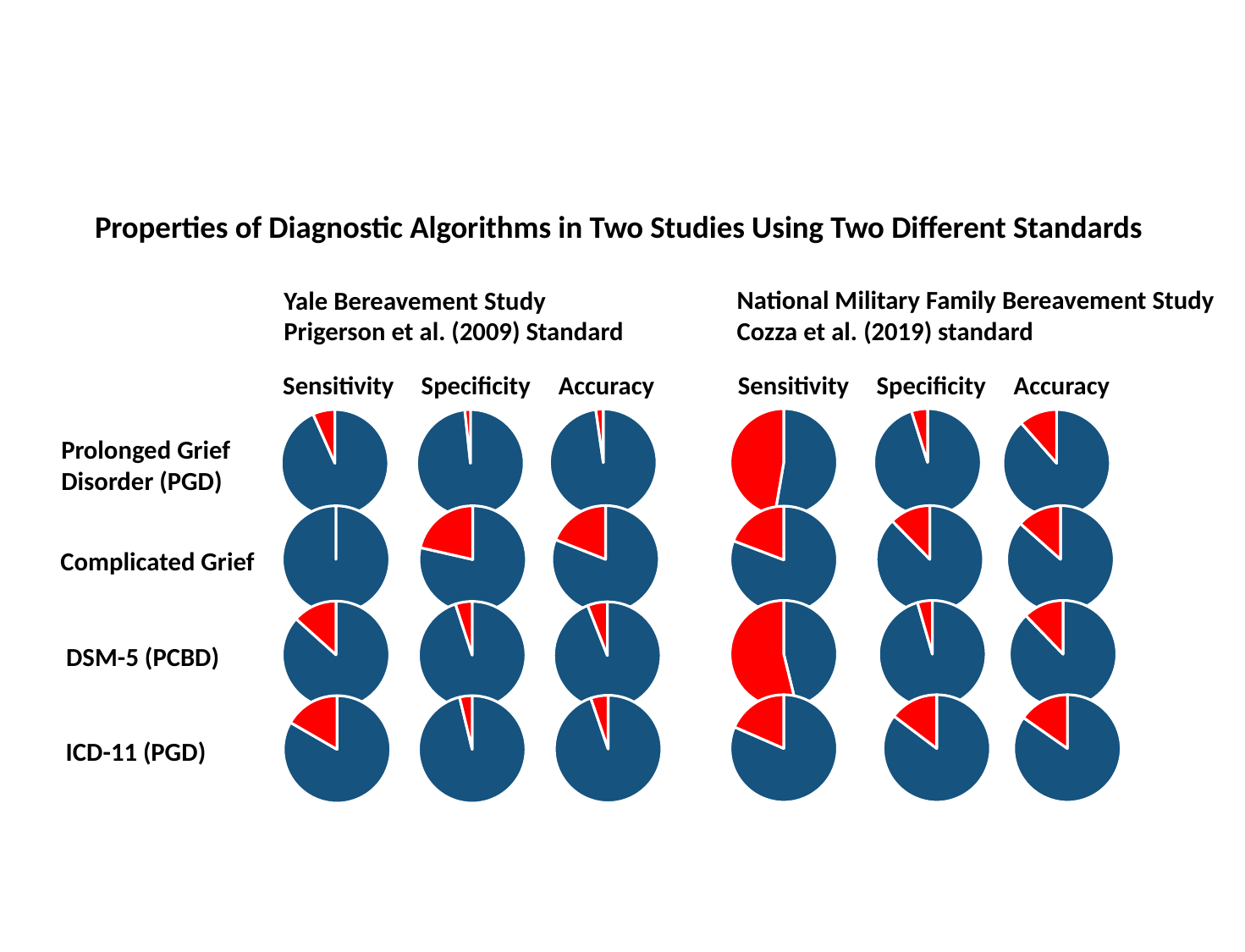
How many pie charts are shown on the slide in total? 24 What kind of charts are shown on the slide? Pie charts How many diagnostic algorithms (rows of pie charts) are shown on the slide? 4 In the Yale Bereavement Study, which pie chart for Complicated Grief has the larger red slice: Sensitivity or Specificity? Specificity In the National Military Family Bereavement Study, which pie chart for Prolonged Grief Disorder (PGD) has the larger red slice: Sensitivity or Specificity? Sensitivity In the Yale Bereavement Study, which pie chart for Complicated Grief has the smallest red slice: Sensitivity, Specificity or Accuracy? Sensitivity Which standard is used for the National Military Family Bereavement Study pie charts? Cozza et al. (2019) standard For Complicated Grief Sensitivity, which study's pie chart has the larger red slice: the Yale Bereavement Study or the National Military Family Bereavement Study? National Military Family Bereavement Study How many properties (columns of pie charts) are shown for each study? 3 What is the title of the slide's chart display? Properties of Diagnostic Algorithms in Two Studies Using Two Different Standards